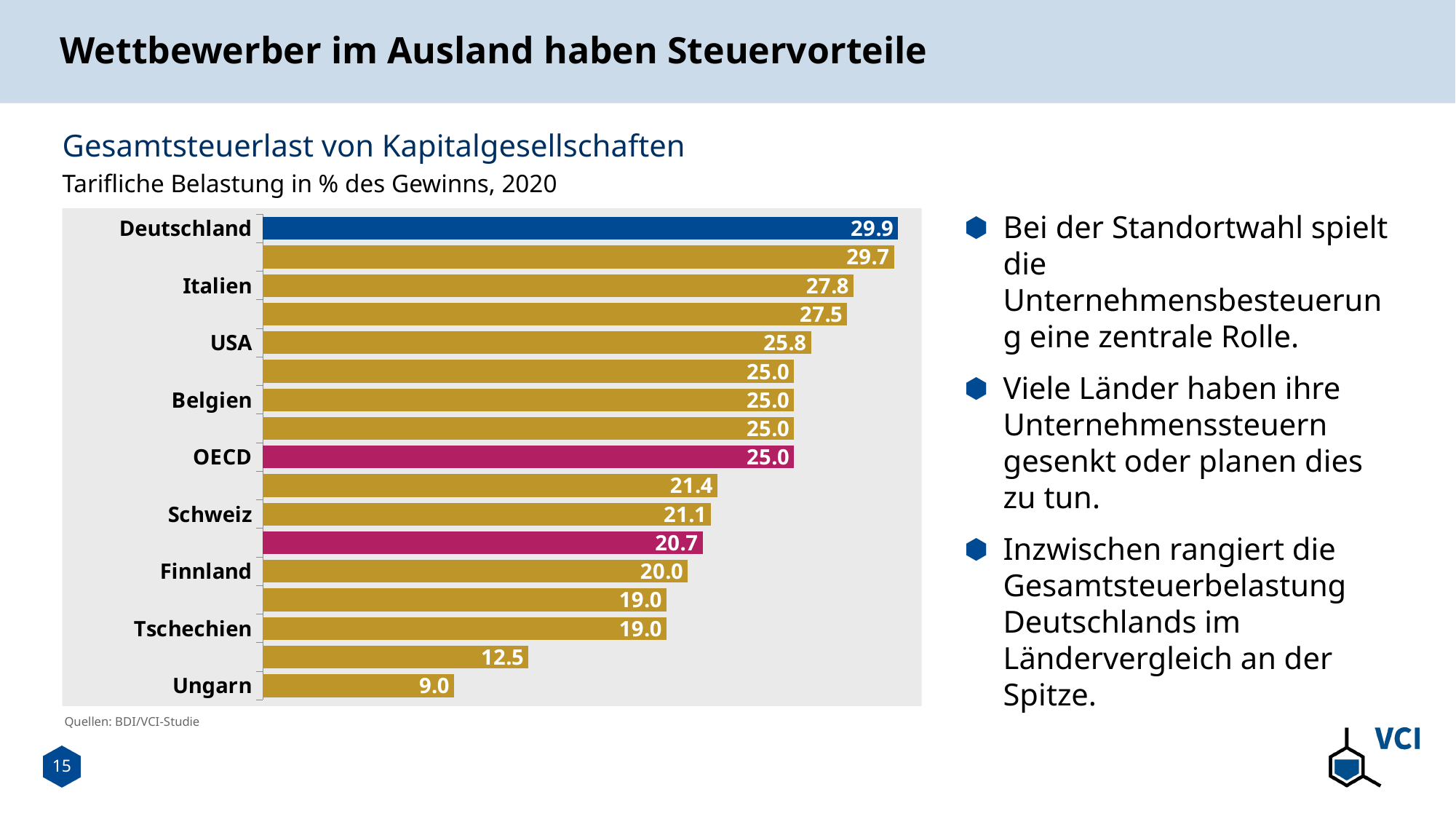
What is the value for Deutschland? 29.9 Which is larger, the value for Belgien or the value for Schweiz? Belgien What is the value for USA? 25.8 What is the value for OECD? 25.0 What is the value for Schweiz? 21.1 What is the value for Ungarn? 9.0 How many bars are plotted in the chart? 17 What kind of chart is shown on the slide? Bar chart What is the difference between the values for Deutschland and Ungarn? 20.9 Which labelled category has the highest value? Deutschland What is the value for Italien? 27.8 Which labelled category has the lowest value? Ungarn